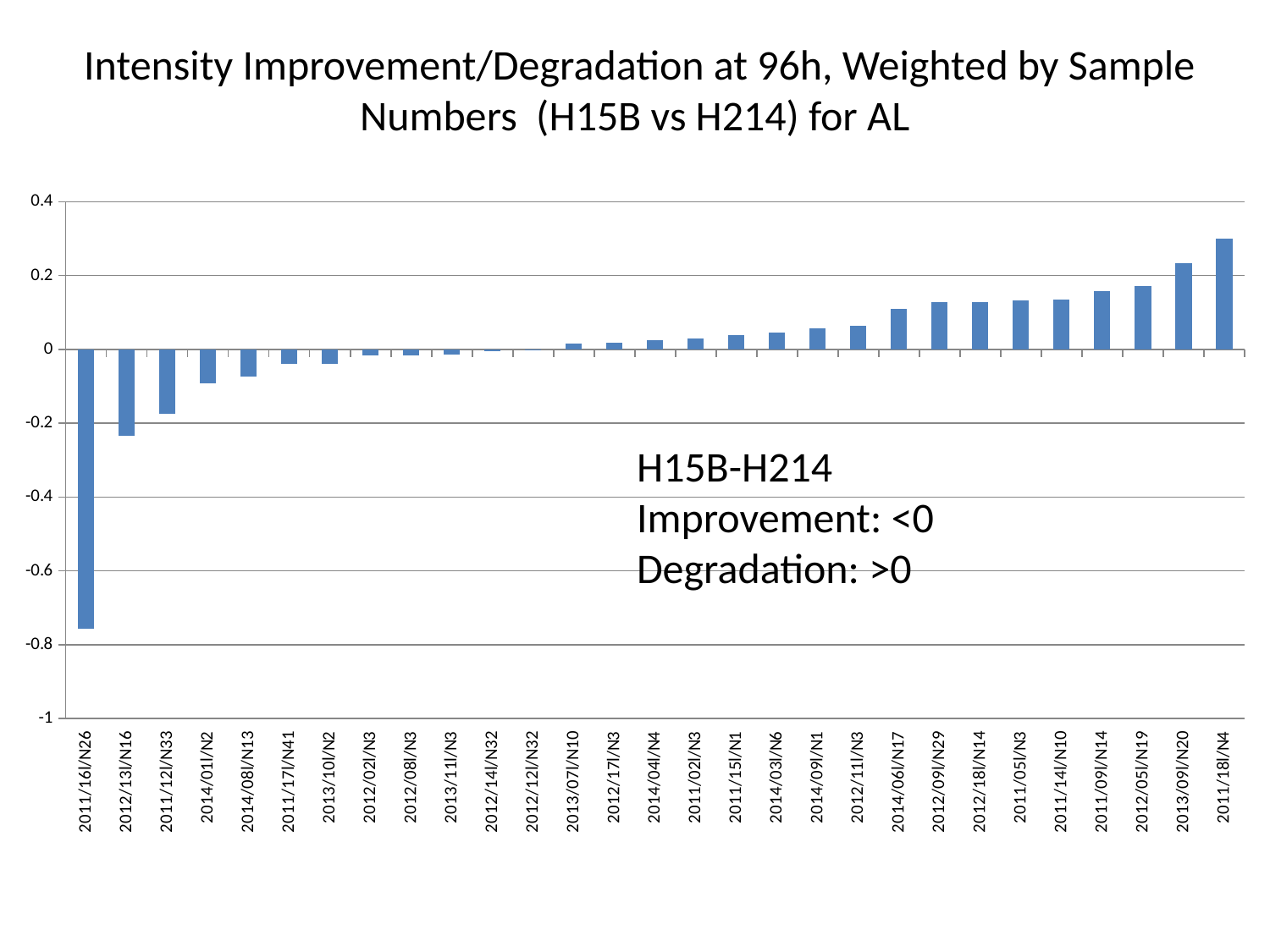
Is the value for 2011/18l/N4 greater or less than 0.2? greater What kind of chart is shown on the slide? bar chart Which has the lower value, 2011/16l/N26 or 2012/13l/N16? 2011/16l/N26 Do the values rise or fall from left to right along the x axis? rise Is the value for 2014/06l/N17 greater or less than 0.2? less Is the value for 2014/01l/N2 greater or less than -0.2? greater According to the text on the chart, does a value below 0 indicate improvement or degradation? Improvement How many categories are plotted along the x axis? 29 Which category has the lowest value? 2011/16l/N26 Which category has the highest value? 2011/18l/N4 Which has the larger value, 2011/18l/N4 or 2013/09l/N20? 2011/18l/N4